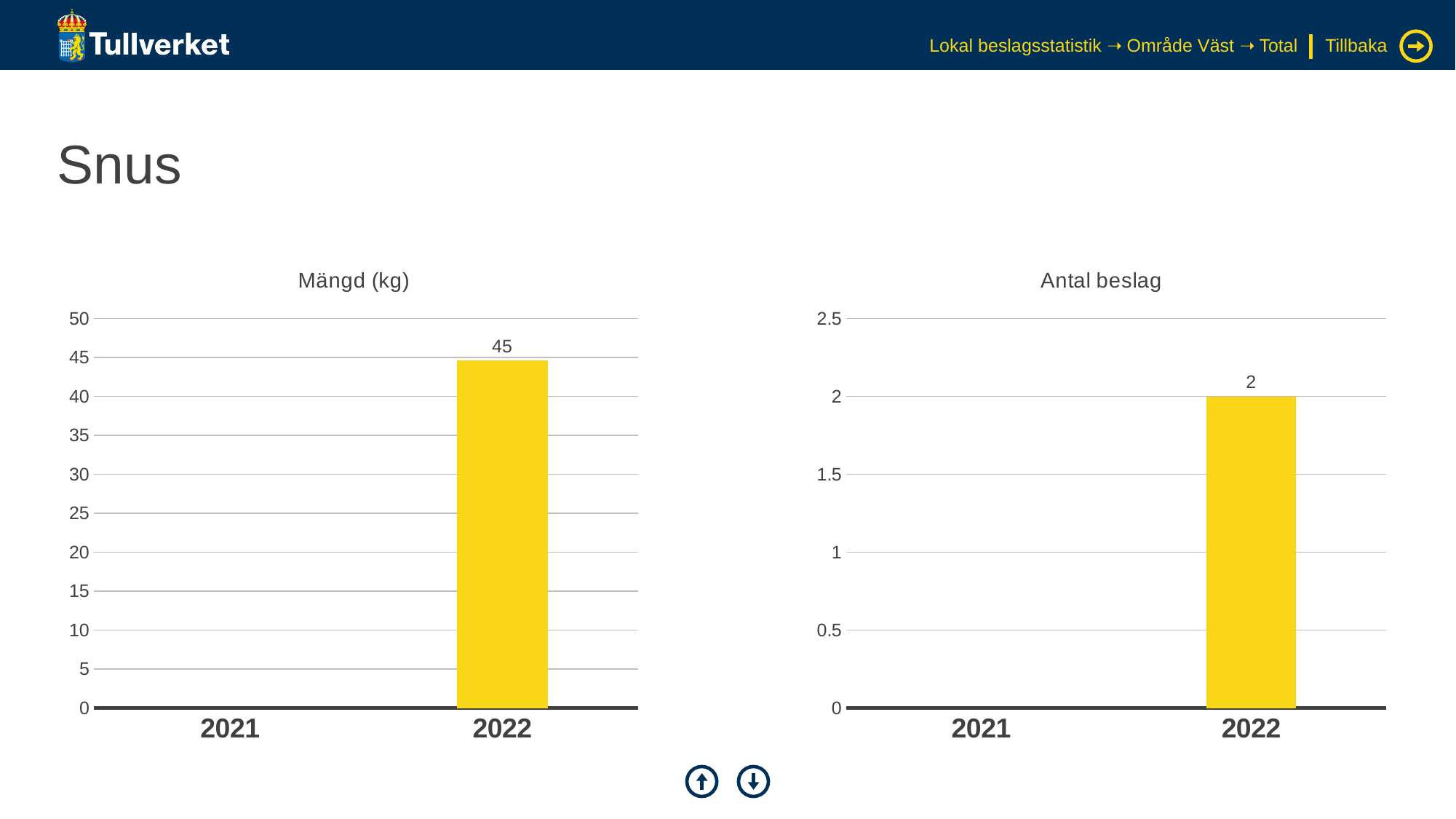
How many years are shown on the x axis of the "Mängd (kg)" chart? 2 How many years are shown on the x axis of the "Antal beslag" chart? 2 What is the title of the chart on the left side of the slide? Mängd (kg) In the "Mängd (kg)" chart, is the value for 2022 greater or less than 40? greater In the "Antal beslag" chart, what is the value for 2022? 2 What is the title of the chart on the right side of the slide? Antal beslag What kind of chart is the "Antal beslag" chart? bar chart In the "Mängd (kg)" chart, what is the value for 2022? 45 In the "Antal beslag" chart, which year has the highest value? 2022 In the "Antal beslag" chart, is the value for 2022 greater or less than 1.5? greater In the "Mängd (kg)" chart, do the values rise or fall from 2021 to 2022? rise In the "Mängd (kg)" chart, which year has the highest value? 2022